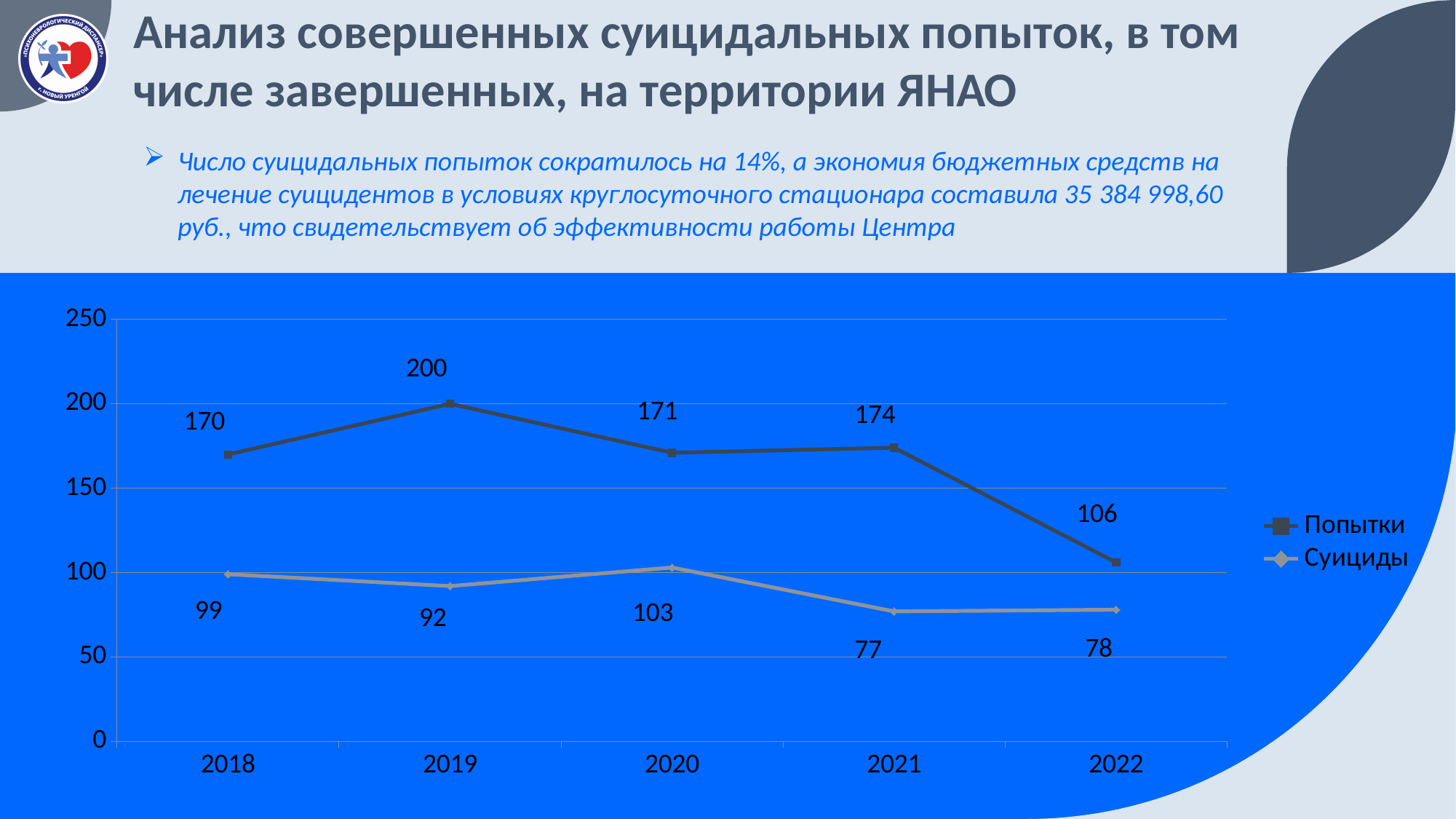
How many years are shown on the x axis? 5 What is the difference between Попытки in 2019 and Попытки in 2022? 94 What was the value for Суициды in 2021? 77 What kind of chart is shown on the slide? line chart Does the Попытки series rise or fall from 2021 to 2022? fall Which is larger: Суициды in 2020 or Суициды in 2019? Суициды in 2020 What was the value for Попытки in 2019? 200 What was the value for Попытки in 2022? 106 How many series does the legend list? 2 In which year was the Суициды series lowest? 2021 Is the value for Попытки in 2021 greater or less than 150? greater In which year was the Попытки series highest? 2019